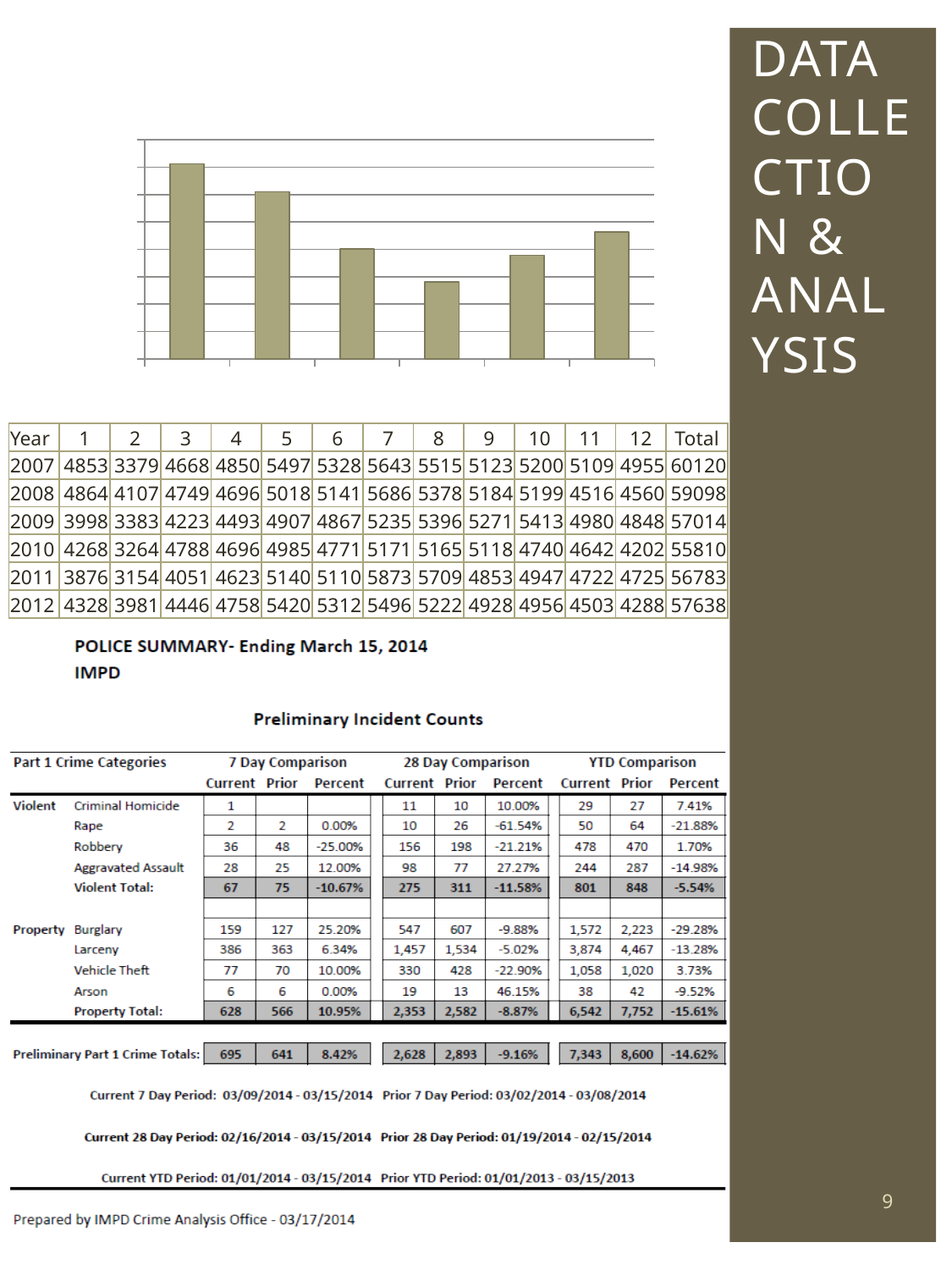
In the chart at the top of the slide, is the sixth bar from the left taller or shorter than the fifth bar? taller In the chart at the top of the slide, which bar is the tallest, counting from the left? the first bar How many bars does the chart at the top of the slide contain? 6 In the chart at the top of the slide, is the second bar from the left taller or shorter than the third bar? taller What colour are the bars in the chart at the top of the slide? khaki/olive tan What kind of chart is shown at the top of the slide? bar chart In the chart at the top of the slide, which bar is the shortest, counting from the left? the fourth bar In the chart at the top of the slide, do the bar heights rise or fall from the first bar to the fourth bar? fall Does the chart at the top of the slide display a legend? No In the chart at the top of the slide, do the bar heights rise or fall from the fourth bar to the sixth bar? rise